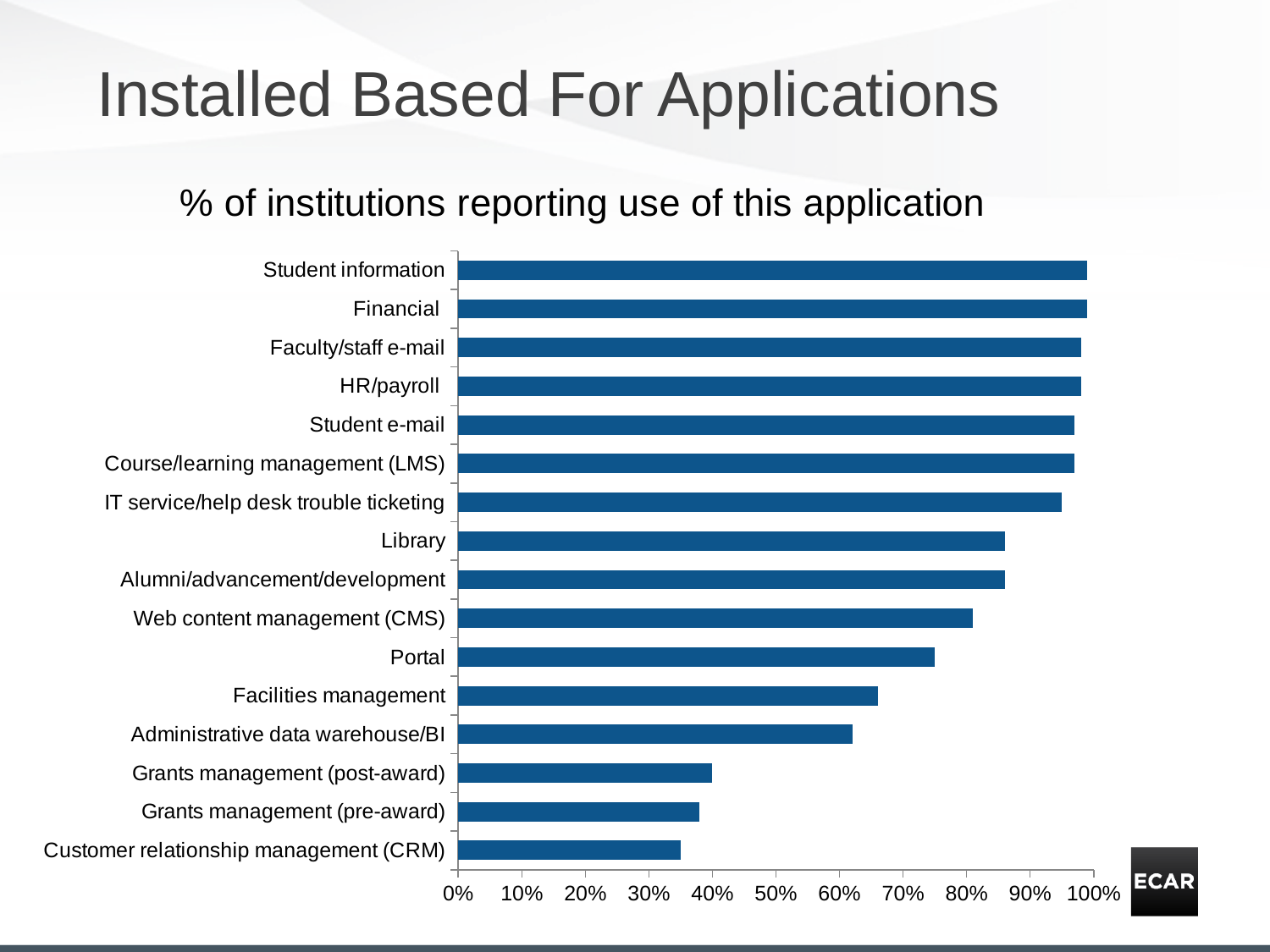
What kind of chart is shown on the slide? bar chart Which has a higher value, Portal or Facilities management? Portal Is the value for IT service/help desk trouble ticketing greater or less than 90%? greater Which has a higher value, Library or Web content management (CMS)? Library Is the value for Administrative data warehouse/BI greater or less than 70%? less Which application has the lowest percentage of institutions reporting use? Customer relationship management (CRM) How many applications (categories) are listed on the chart? 16 Is the value for Library greater or less than 80%? greater What is the title of the chart? % of institutions reporting use of this application